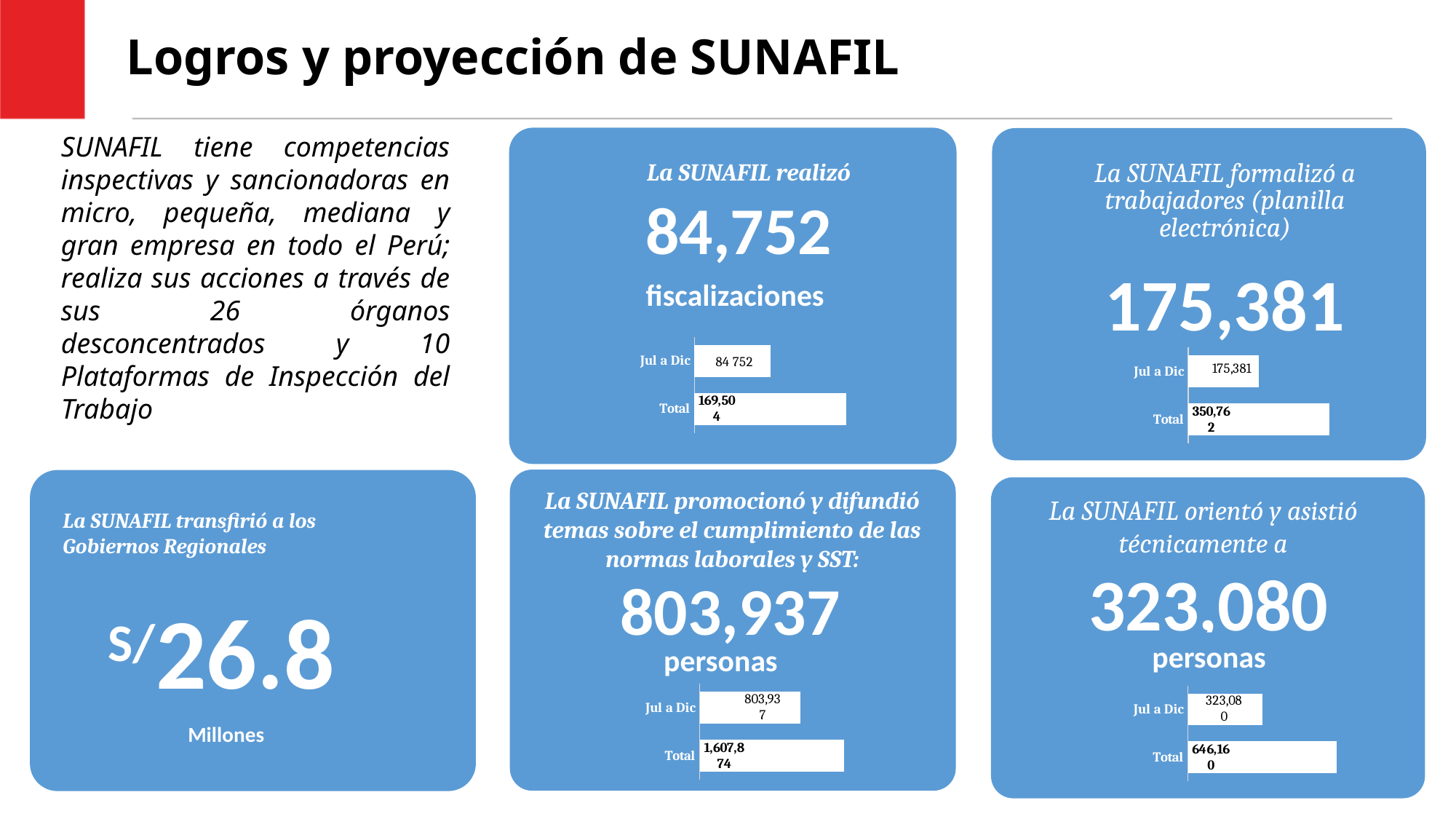
In the 'La SUNAFIL promocionó y difundió' chart (bottom middle), which category has the highest value? Total In the 'La SUNAFIL realizó 84,752 fiscalizaciones' chart (top middle), what is the value for Jul a Dic? 84 752 In the 'La SUNAFIL promocionó y difundió' chart (bottom middle), what is the value for Total? 1,607,874 How many categories are shown in the 'La SUNAFIL realizó 84,752 fiscalizaciones' chart (top middle)? 2 In the 'La SUNAFIL orientó y asistió técnicamente' chart (bottom right), what is the value for Total? 646,160 In the 'La SUNAFIL orientó y asistió técnicamente' chart (bottom right), what is the difference between Total and Jul a Dic? 323,080 In the 'La SUNAFIL formalizó a trabajadores' chart (top right), what is the value for Total? 350,762 In the 'La SUNAFIL formalizó a trabajadores' chart (top right), what is the value for Jul a Dic? 175,381 In the 'La SUNAFIL orientó y asistió técnicamente' chart (bottom right), what is the value for Jul a Dic? 323,080 What type of chart is used in the 'La SUNAFIL formalizó a trabajadores' panel (top right)? Bar chart In the 'La SUNAFIL formalizó a trabajadores' chart (top right), which category has the lowest value? Jul a Dic In the 'La SUNAFIL realizó 84,752 fiscalizaciones' chart (top middle), what is the value for Total? 169,504